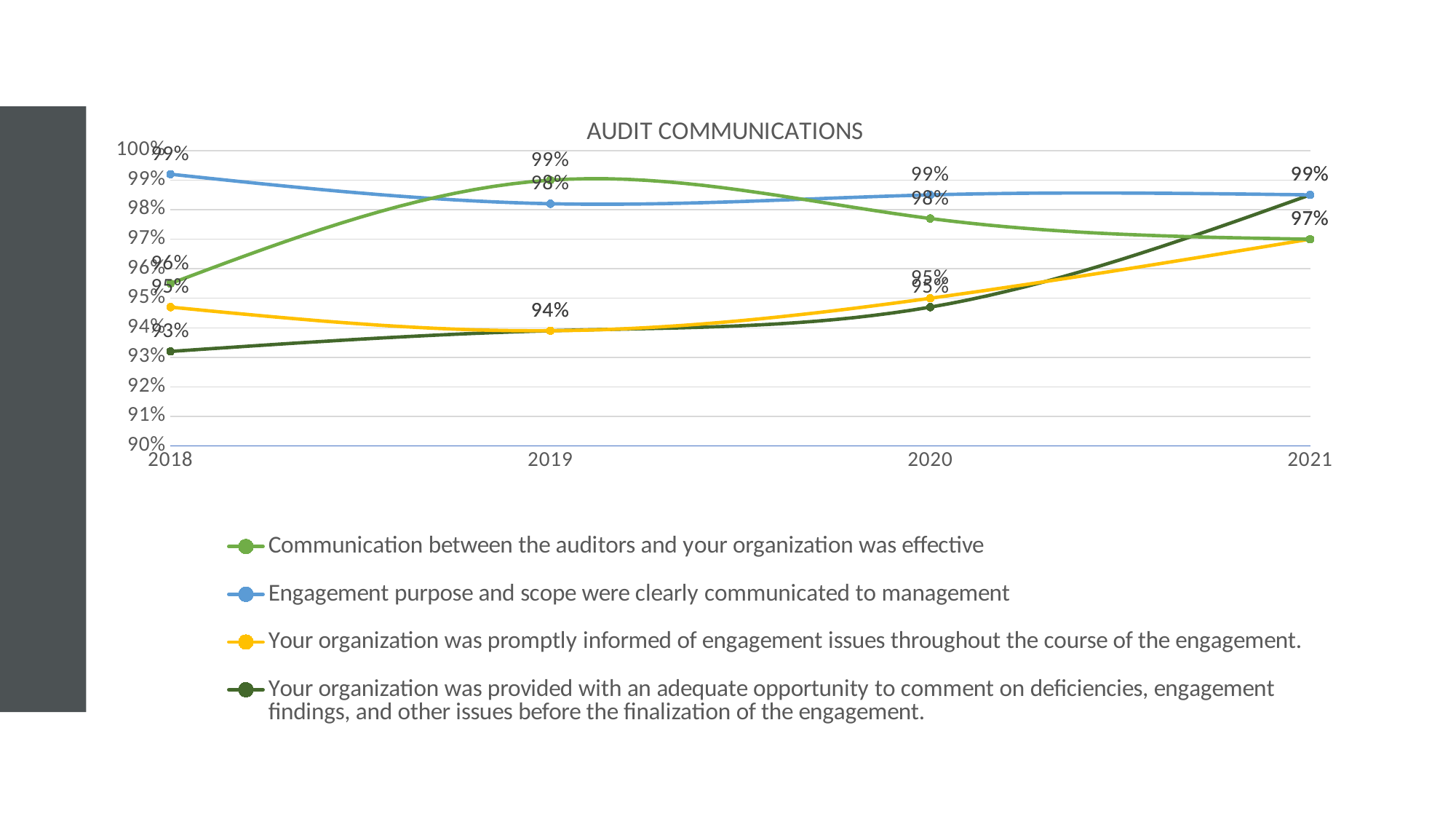
How many years are shown on the x axis? 4 Which series has the lowest value in 2018? Your organization was provided with an adequate opportunity to comment on deficiencies, engagement findings, and other issues before the finalization of the engagement. What is the title of the chart? AUDIT COMMUNICATIONS Does the value for 'Your organization was provided with an adequate opportunity to comment on deficiencies, engagement findings, and other issues before the finalization of the engagement.' rise or fall from 2018 to 2021? Rise In 2018, what is the difference between 'Engagement purpose and scope were clearly communicated to management' and 'Your organization was provided with an adequate opportunity to comment on deficiencies, engagement findings, and other issues before the finalization of the engagement.'? 6 percentage points What is the value for 'Communication between the auditors and your organization was effective' in 2020? 98% What is the value for 'Communication between the auditors and your organization was effective' in 2019? 99% How many series does the legend list? 4 What kind of chart is shown on the slide? Line chart Which series has the highest value in 2018? Engagement purpose and scope were clearly communicated to management What is the value in 2018 for 'Your organization was provided with an adequate opportunity to comment on deficiencies, engagement findings, and other issues before the finalization of the engagement.'? 93% What is the value for 'Engagement purpose and scope were clearly communicated to management' in 2018? 99%